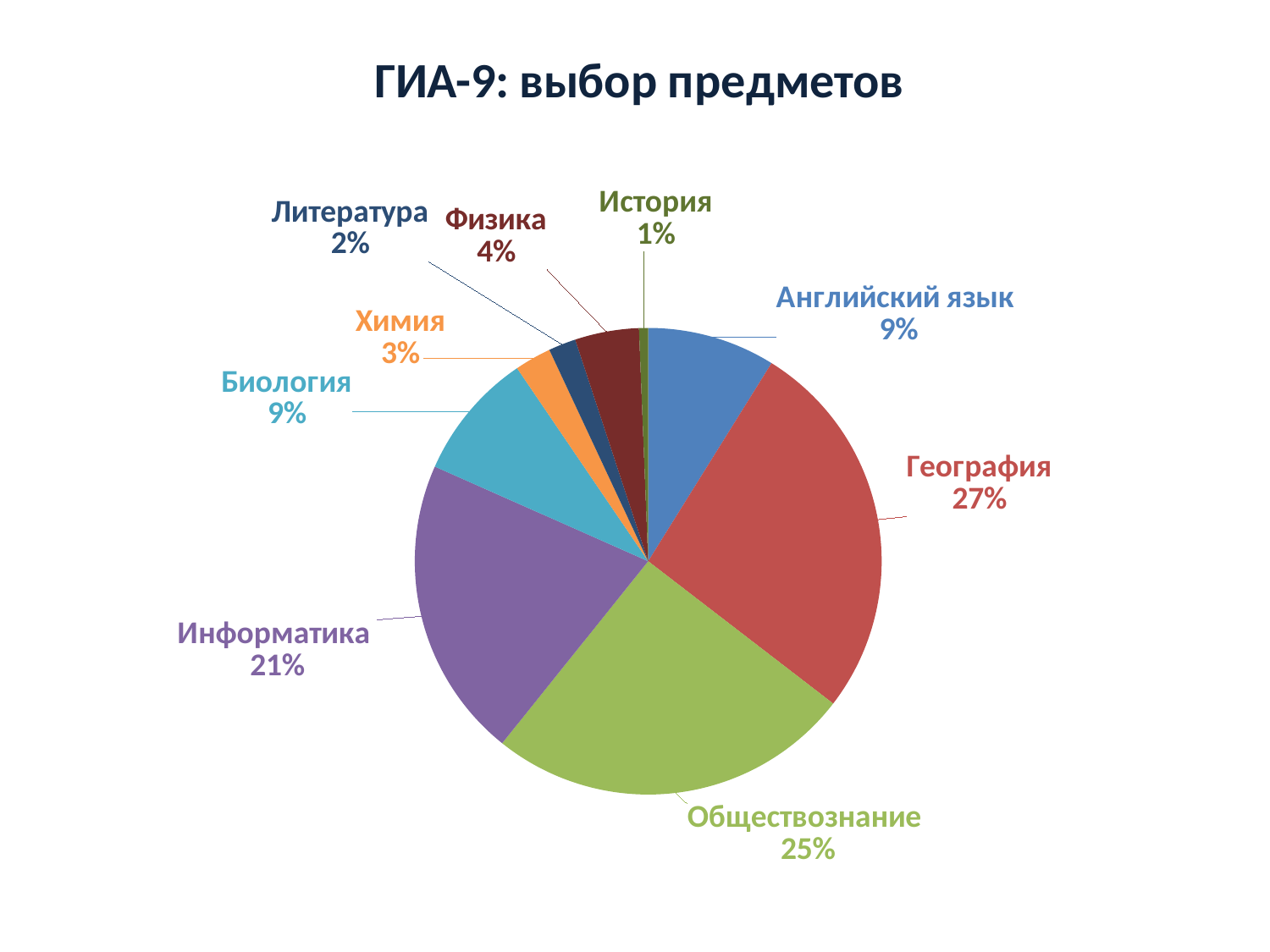
Which subject has the largest slice of the pie? География Which is larger, the share for Информатика or the share for Обществознание? Обществознание What is the difference between the shares of Биология and Литература? 7% What is the value shown for Информатика? 21% Which subject has the smallest slice of the pie? История How many subjects (slices) are shown in the pie chart? 9 What is the value shown for Химия? 3% What is the difference between the shares of География and Обществознание? 2% What type of chart is shown on the slide? pie chart What is the value shown for Физика? 4% What is the title of the chart? ГИА-9: выбор предметов What share of the pie does География have? 27%